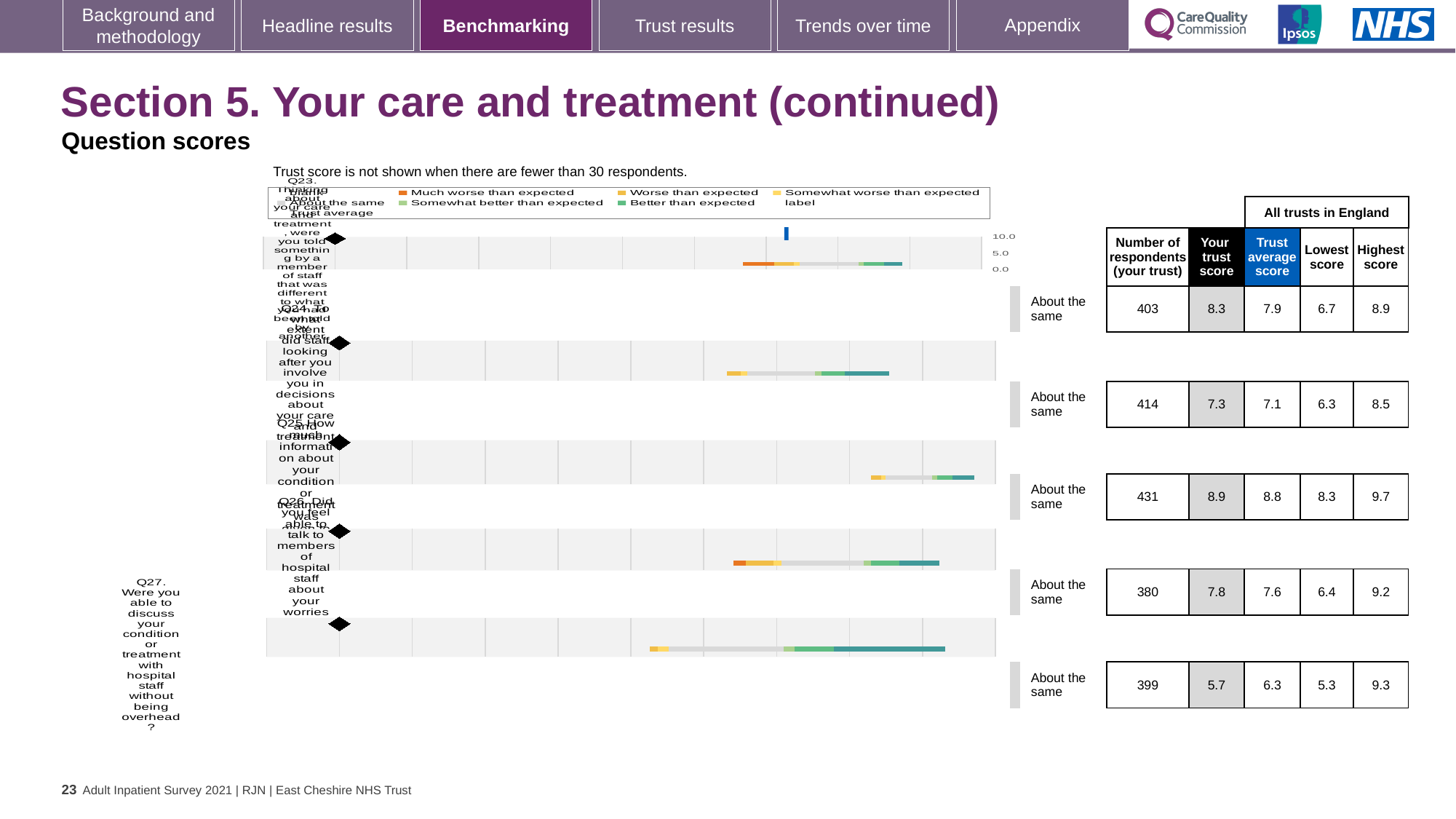
Which question has the fewest respondents? Q26 What kind of chart is used to show the question scores on this slide? bar chart For Q27, which is larger: 'Your trust score' or the trust average score? Trust average score What is the difference between 'Your trust score' and the trust average score for Q23? 0.4 What benchmark category is shown next to each question's bar? About the same What is the trust average score for Q24 (staff involving you in decisions about your care and treatment)? 7.1 Which question has the lowest 'Your trust score'? Q27 What is the number of respondents for Q25 (how much information about your condition or treatment)? 431 What is the 'Your trust score' for Q27 (discussing your condition or treatment without being overheard)? 5.7 What is the highest score across all trusts in England for Q26 (able to talk to hospital staff about your worries)? 9.2 Which question has the highest 'Your trust score'? Q25 How many questions (Q23 to Q27) are plotted in the chart? 5